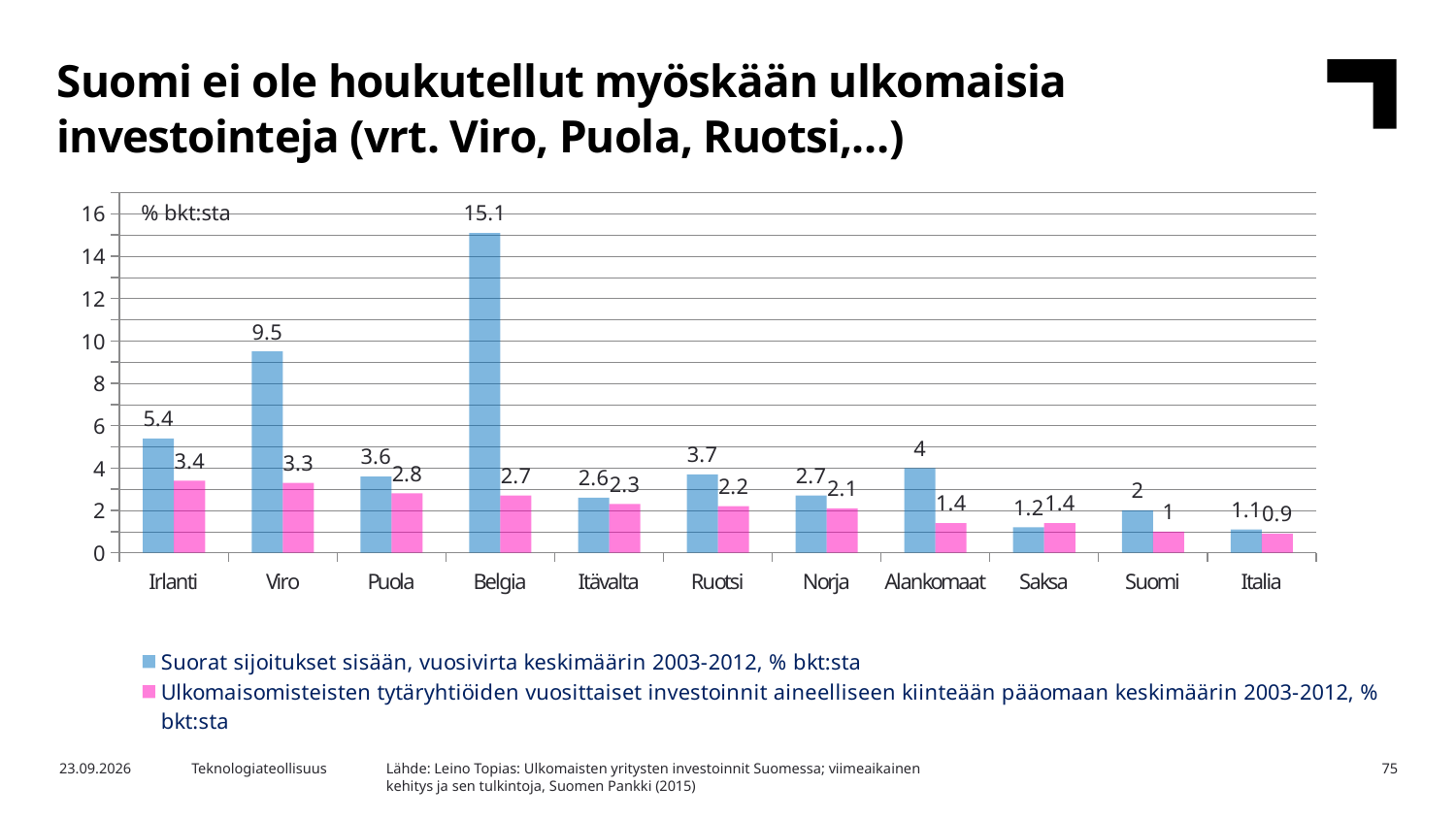
What is the value of the blue series (Suorat sijoitukset sisään) for Belgia? 15.1 Is the blue series value for Irlanti greater or less than 4? greater What is the value of the pink series (Ulkomaisomisteisten tytäryhtiöiden investoinnit) for Suomi? 1 Which country has the highest value in the blue series (Suorat sijoitukset sisään)? Belgia How many countries are shown on the x axis? 11 Which is larger for Saksa: the blue series value or the pink series value? the pink series value (1.4) What is the difference between the blue series values for Belgia and Viro? 5.6 What unit is indicated at the top of the y axis? % bkt:sta How many series does the legend list? 2 What kind of chart is shown on the slide? bar chart What is the value of the blue series for Viro? 9.5 Which country has the lowest value in the pink series (Ulkomaisomisteisten tytäryhtiöiden investoinnit)? Italia